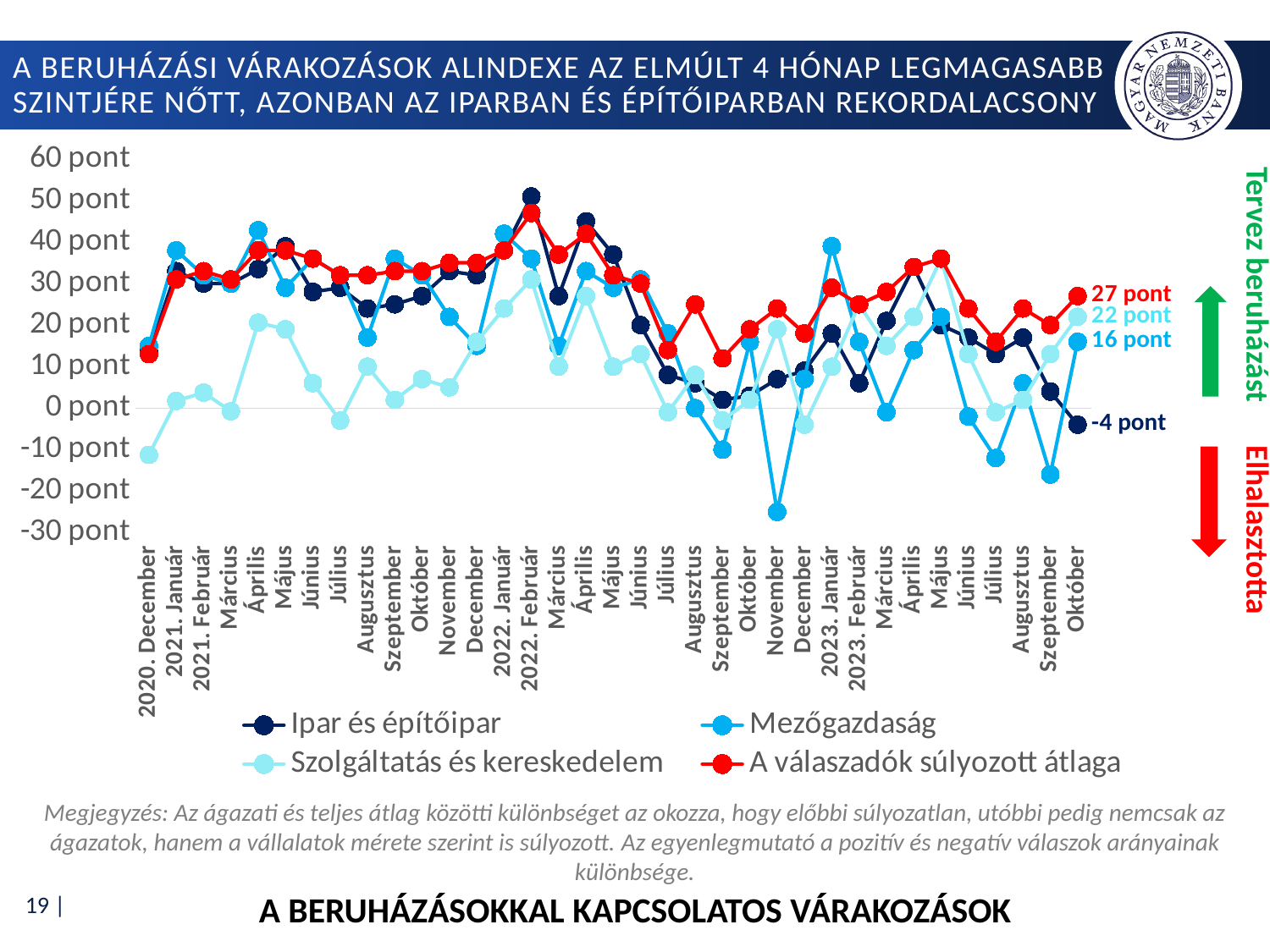
What is the value for Mezőgazdaság in 2023 Október? 16 pont What is the value for Ipar és építőipar in 2023 Október? -4 pont Which series has the highest value in 2023 Október? A válaszadók súlyozott átlaga In 2023 Október, which is larger: Szolgáltatás és kereskedelem or Mezőgazdaság? Szolgáltatás és kereskedelem What is the difference between A válaszadók súlyozott átlaga and Ipar és építőipar in 2023 Október? 31 pont What kind of chart is shown on the slide? Line chart How many series does the legend list? 4 Is the value for Mezőgazdaság in 2022 November greater or less than -20 pont? less Is the value for Ipar és építőipar in 2022 Február greater or less than 40 pont? greater What is the value for Szolgáltatás és kereskedelem in 2023 Október? 22 pont What is the value for A válaszadók súlyozott átlaga in 2023 Október? 27 pont Which series has the lowest value in 2023 Október? Ipar és építőipar